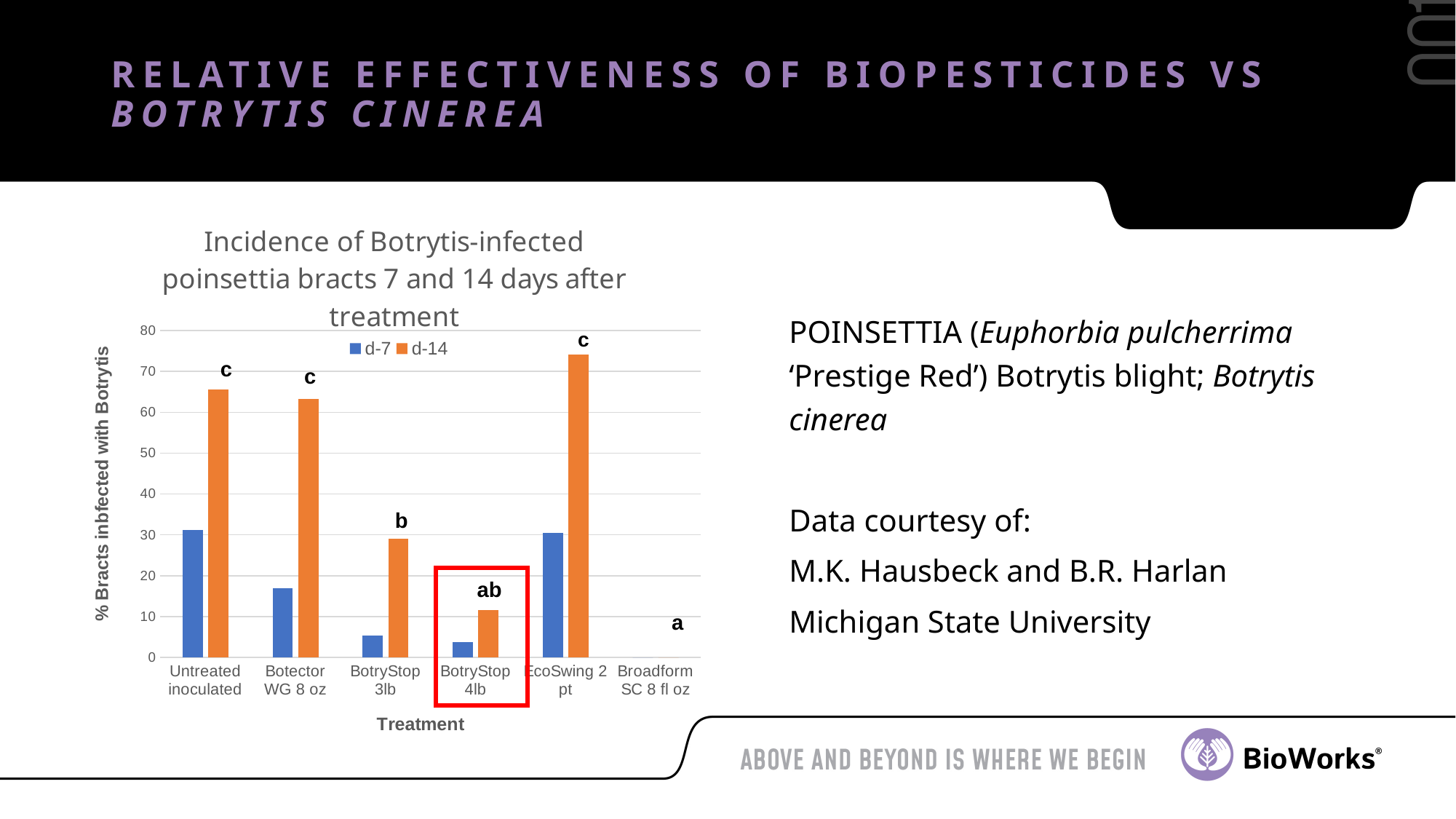
Which is larger, the d-7 value for Untreated inoculated or the d-7 value for Botector WG 8 oz? Untreated inoculated How many treatment categories are shown on the x axis? 6 Is the d-14 value for BotryStop 4lb greater or less than 20? less Is the d-14 value for Untreated inoculated greater or less than 60? greater Which treatment has the lowest d-14 value? Broadform SC 8 fl oz Is the d-7 value for Botector WG 8 oz greater or less than 20? less Which treatment has the highest d-14 value? EcoSwing 2 pt How many series does the chart legend list? 2 Which is larger, the d-14 value for BotryStop 3lb or the d-14 value for BotryStop 4lb? BotryStop 3lb What kind of chart is shown on the slide? bar chart Which treatment is highlighted with a red box on the chart? BotryStop 4lb